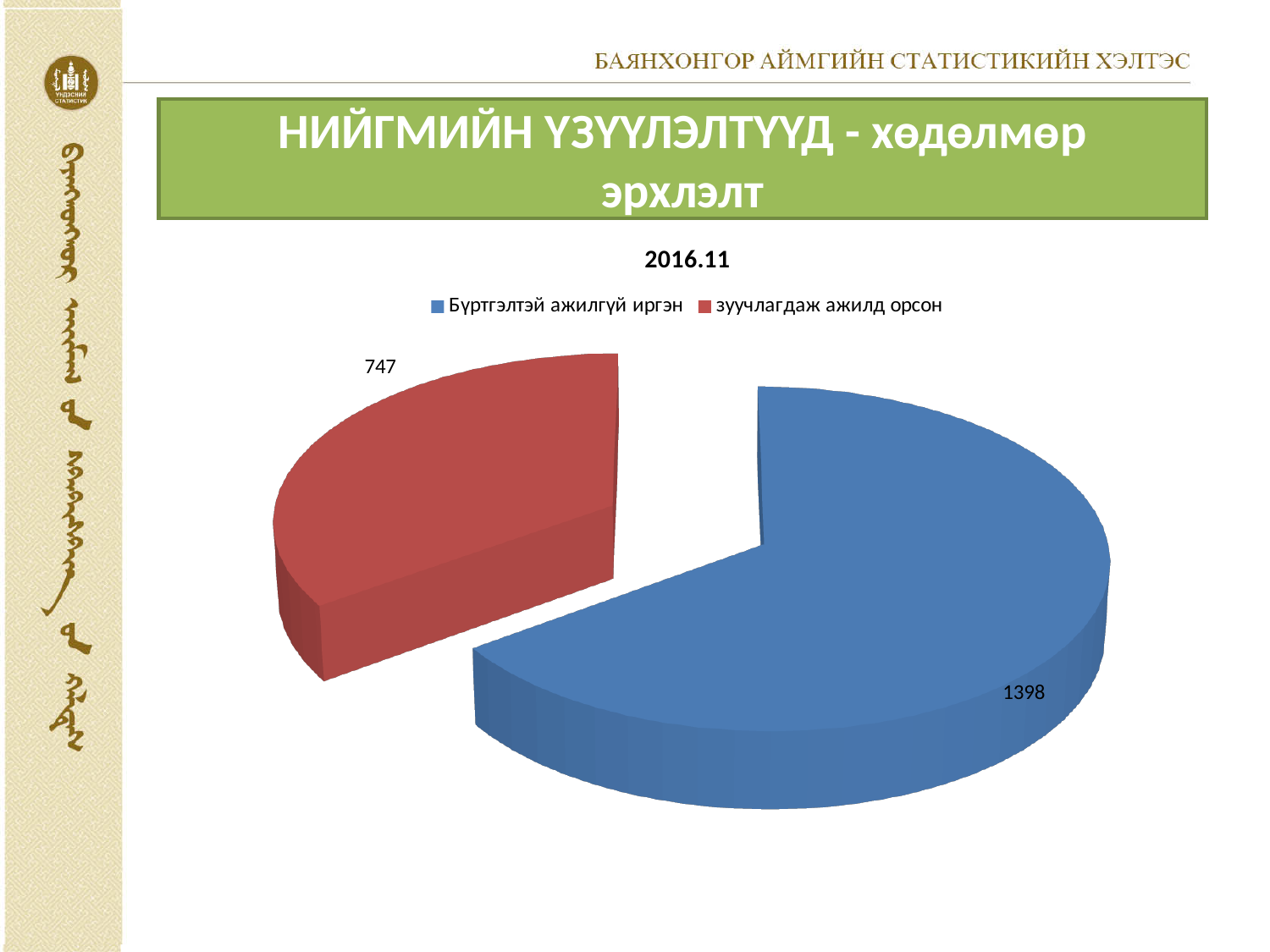
What is the value for зуучлагдаж ажилд орсон? 747 What is the title of the chart? 2016.11 What kind of chart is shown on the slide? pie chart Which is larger, the value for Бүртгэлтэй ажилгүй иргэн or the value for зуучлагдаж ажилд орсон? Бүртгэлтэй ажилгүй иргэн How many slices does the pie chart have? 2 What is the difference between the values for Бүртгэлтэй ажилгүй иргэн and зуучлагдаж ажилд орсон? 651 How many entries does the legend list? 2 Which category has the smallest slice of the pie? зуучлагдаж ажилд орсон What is the value for Бүртгэлтэй ажилгүй иргэн? 1398 What colour is the slice for зуучлагдаж ажилд орсон? red What is the total of the two values shown in the pie chart? 2145 Which category has the largest slice of the pie? Бүртгэлтэй ажилгүй иргэн